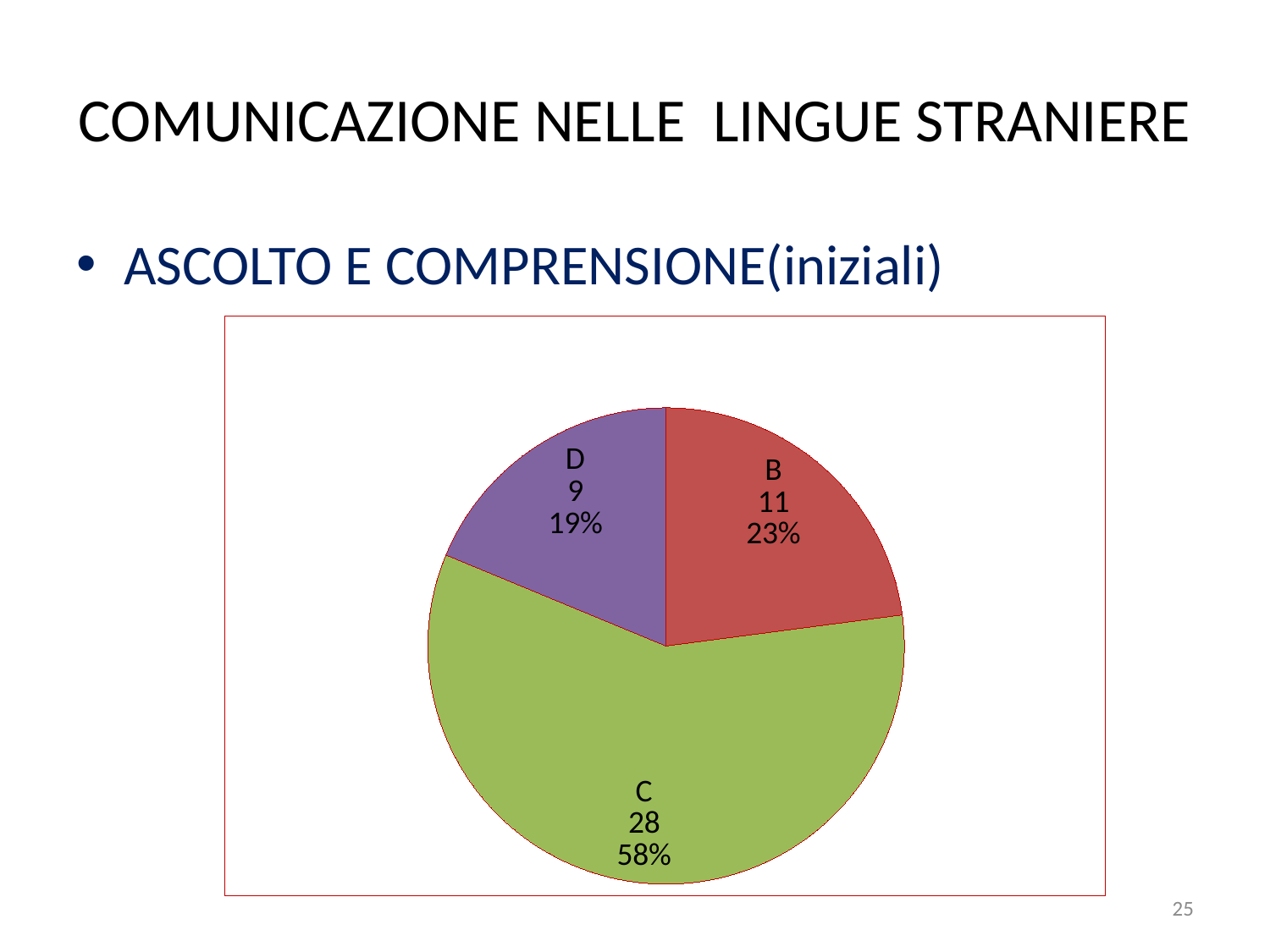
What is the difference between the values for C and B? 17 What is the value for category C? 28 Which category has the smallest slice? D What is the value for category D? 9 What share of the pie does slice C represent? 58% Which is larger, the value for B or the value for D? B What share of the pie does slice D represent? 19% What colour is the slice for category C? green Which category has the largest slice? C What is the value for category B? 11 What kind of chart is shown on the slide? pie chart How many slices does the pie chart have? 3